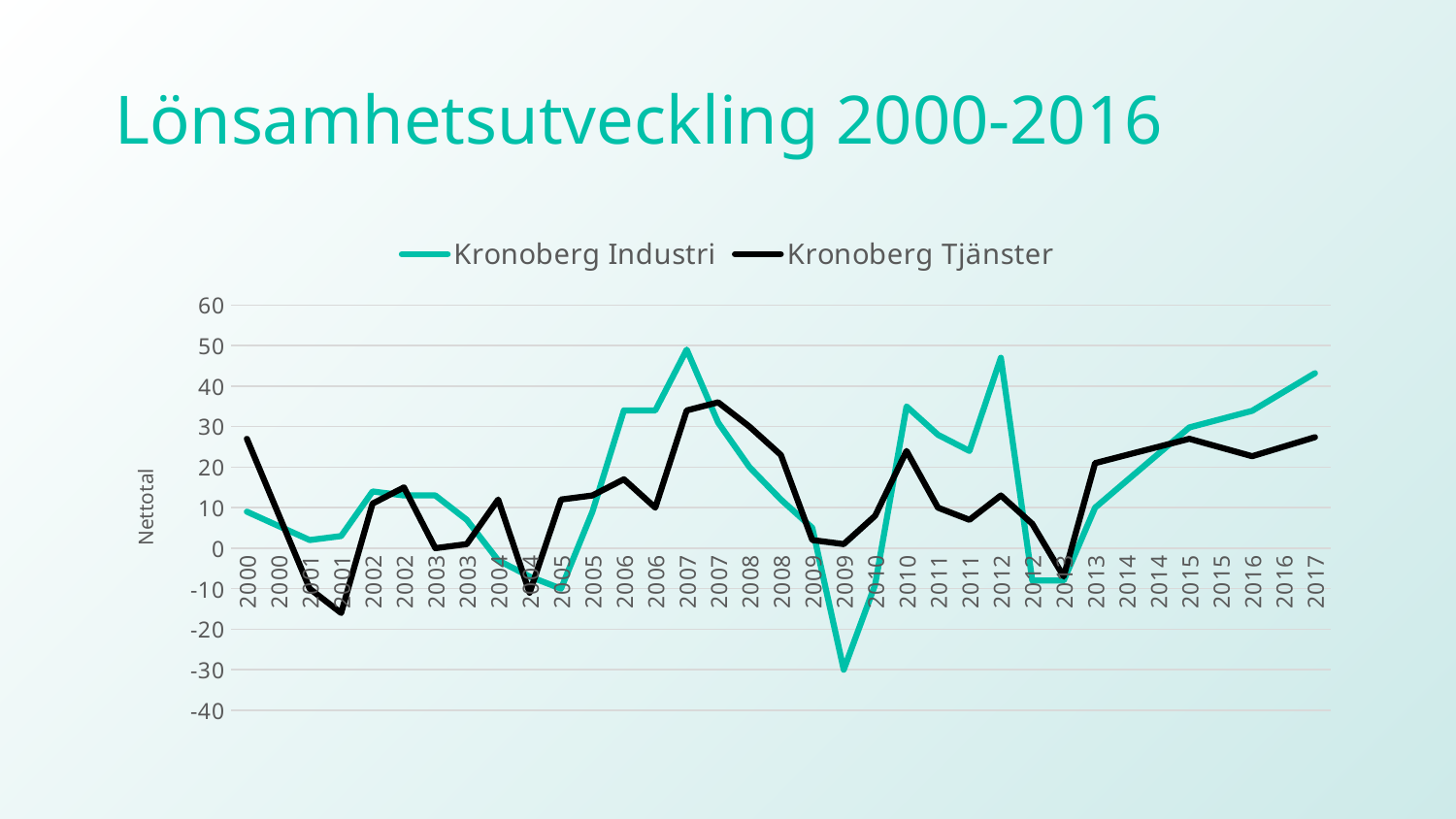
What is the label on the vertical axis? Nettotal At which x-axis point does Kronoberg Tjänster reach its lowest value? 2001 (second point) What kind of chart is shown on the slide? line chart How many series does the legend list? 2 Is the value for Kronoberg Tjänster at the first 2000 point greater or less than 20? greater Does the Kronoberg Industri line rise or fall from the first 2013 point to the 2017 point? rise At the 2017 point, which series has the higher value, Kronoberg Industri or Kronoberg Tjänster? Kronoberg Industri Is the value for Kronoberg Tjänster at the second 2001 point greater or less than -10? less Is the value for Kronoberg Industri at the second 2009 point greater or less than -20? less At which x-axis point does Kronoberg Industri reach its lowest value? 2009 (second point) What is the title of the chart on the slide? Lönsamhetsutveckling 2000-2016